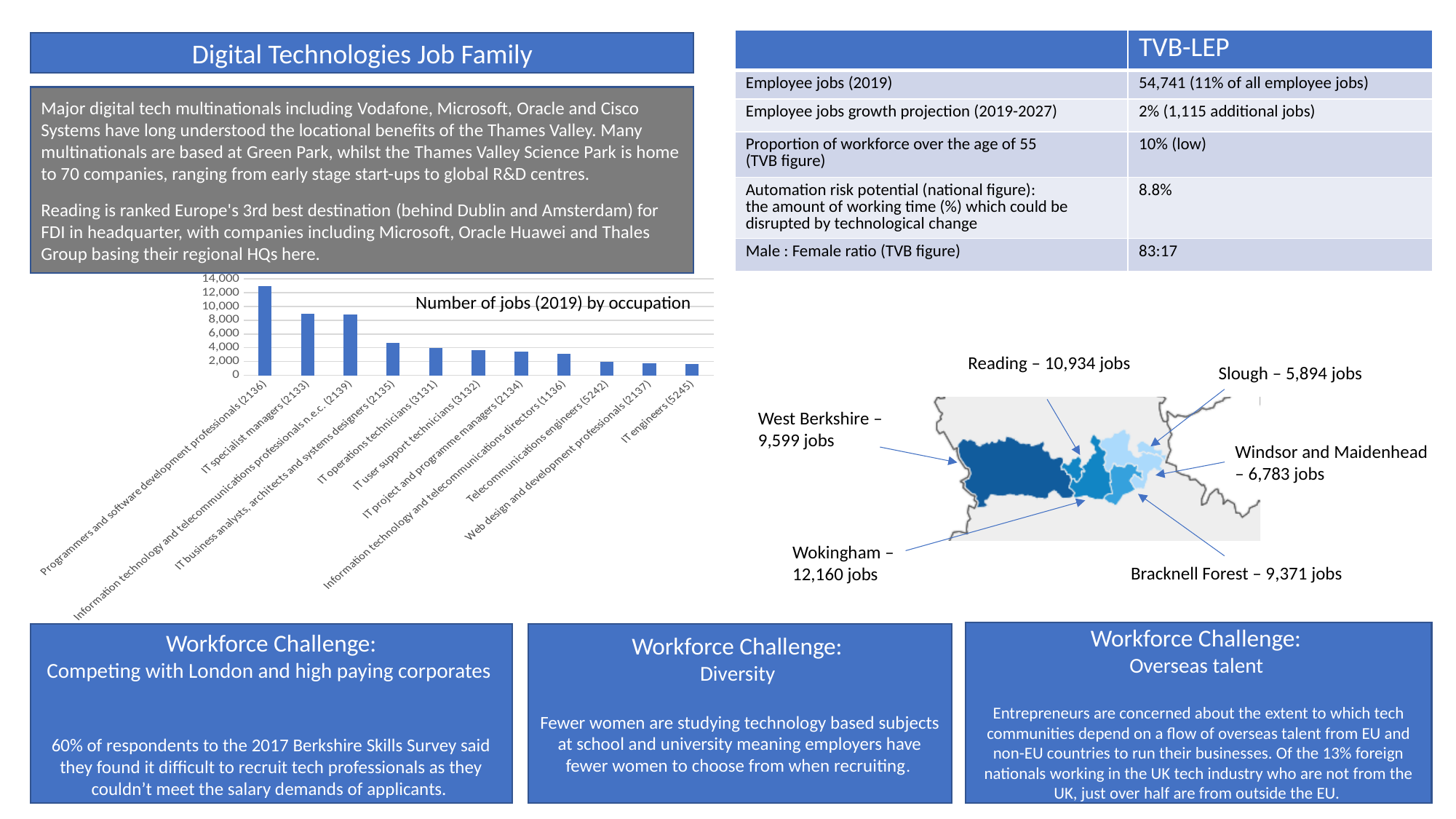
Is the value for Information technology and telecommunications directors (1136) greater or less than 2,000? greater Which has more jobs: IT business analysts, architects and systems designers (2135) or IT user support technicians (3132)? IT business analysts, architects and systems designers (2135) What kind of chart is used to show the number of jobs (2019) by occupation? bar chart How many occupation categories are plotted in the chart? 11 Is the value for IT business analysts, architects and systems designers (2135) greater or less than 4,000? greater Which occupation has the highest number of jobs in the chart? Programmers and software development professionals (2136) Is the value for IT specialist managers (2133) greater or less than 10,000? less Which has more jobs: Programmers and software development professionals (2136) or IT specialist managers (2133)? Programmers and software development professionals (2136) Do the bar values rise or fall moving from left to right along the x axis? fall What is the title of the chart on the slide? Number of jobs (2019) by occupation